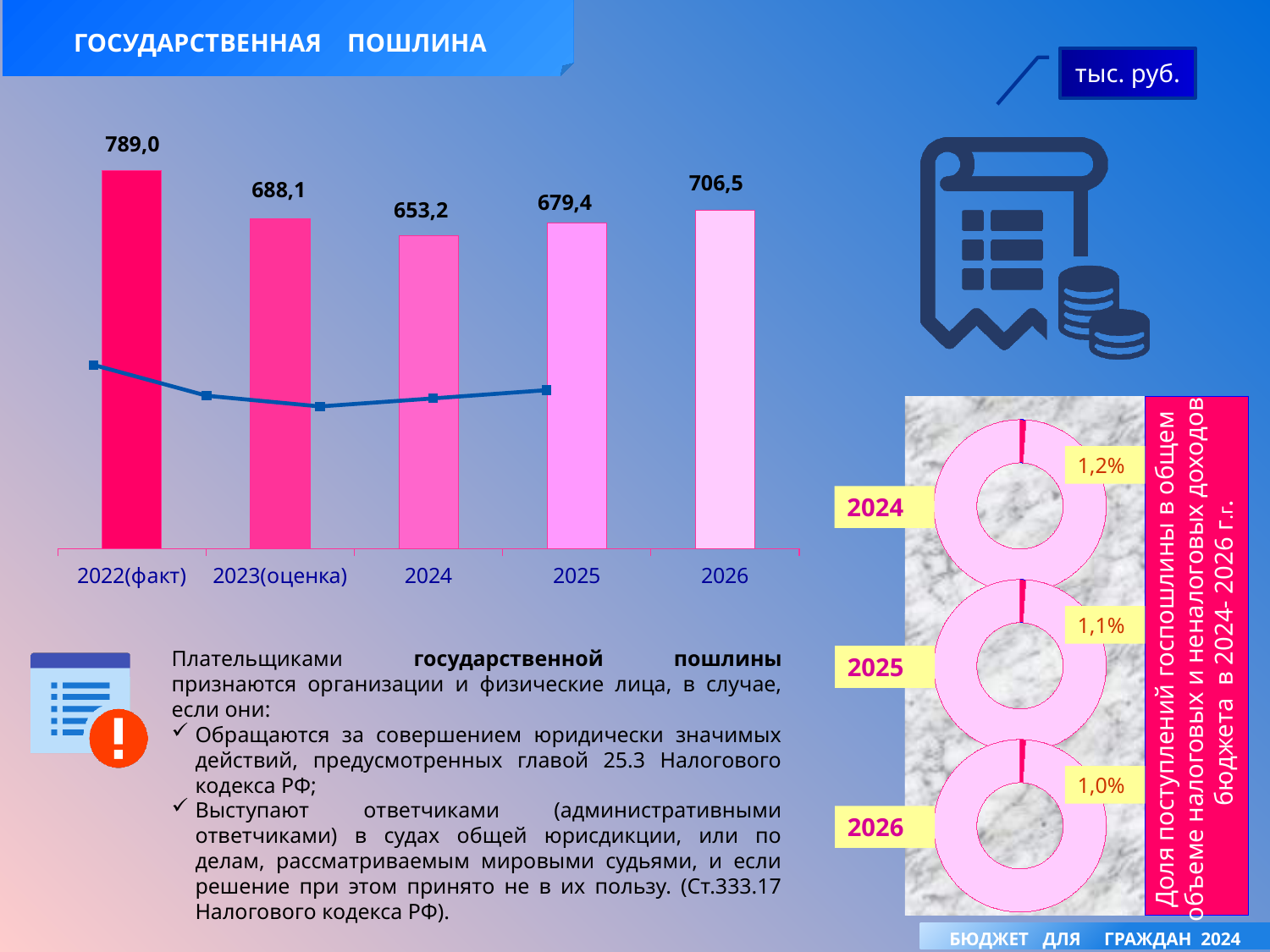
What unit of measurement is indicated for the bar chart 'ГОСУДАРСТВЕННАЯ ПОШЛИНА'? тыс. руб. How many years (categories) are shown in the bar chart 'ГОСУДАРСТВЕННАЯ ПОШЛИНА'? 5 In the bar chart 'ГОСУДАРСТВЕННАЯ ПОШЛИНА', what is the value for 2022(факт)? 789,0 What kind of chart is the main chart on the left of the slide? bar chart In the bar chart 'ГОСУДАРСТВЕННАЯ ПОШЛИНА', which is larger, the value for 2025 or for 2026? 2026 In the donut charts on the right of the slide, what share is shown for 2025? 1,1% In the bar chart 'ГОСУДАРСТВЕННАЯ ПОШЛИНА', what is the difference between the values for 2026 and 2025? 27,1 In the bar chart 'ГОСУДАРСТВЕННАЯ ПОШЛИНА', which year has the lowest value? 2024 In the bar chart 'ГОСУДАРСТВЕННАЯ ПОШЛИНА', what is the value for 2024? 653,2 In the bar chart 'ГОСУДАРСТВЕННАЯ ПОШЛИНА', do the values rise or fall from 2024 to 2026? rise In the bar chart 'ГОСУДАРСТВЕННАЯ ПОШЛИНА', what is the difference between the values for 2022(факт) and 2023(оценка)? 100,9 In the bar chart 'ГОСУДАРСТВЕННАЯ ПОШЛИНА', which year has the highest value? 2022(факт)